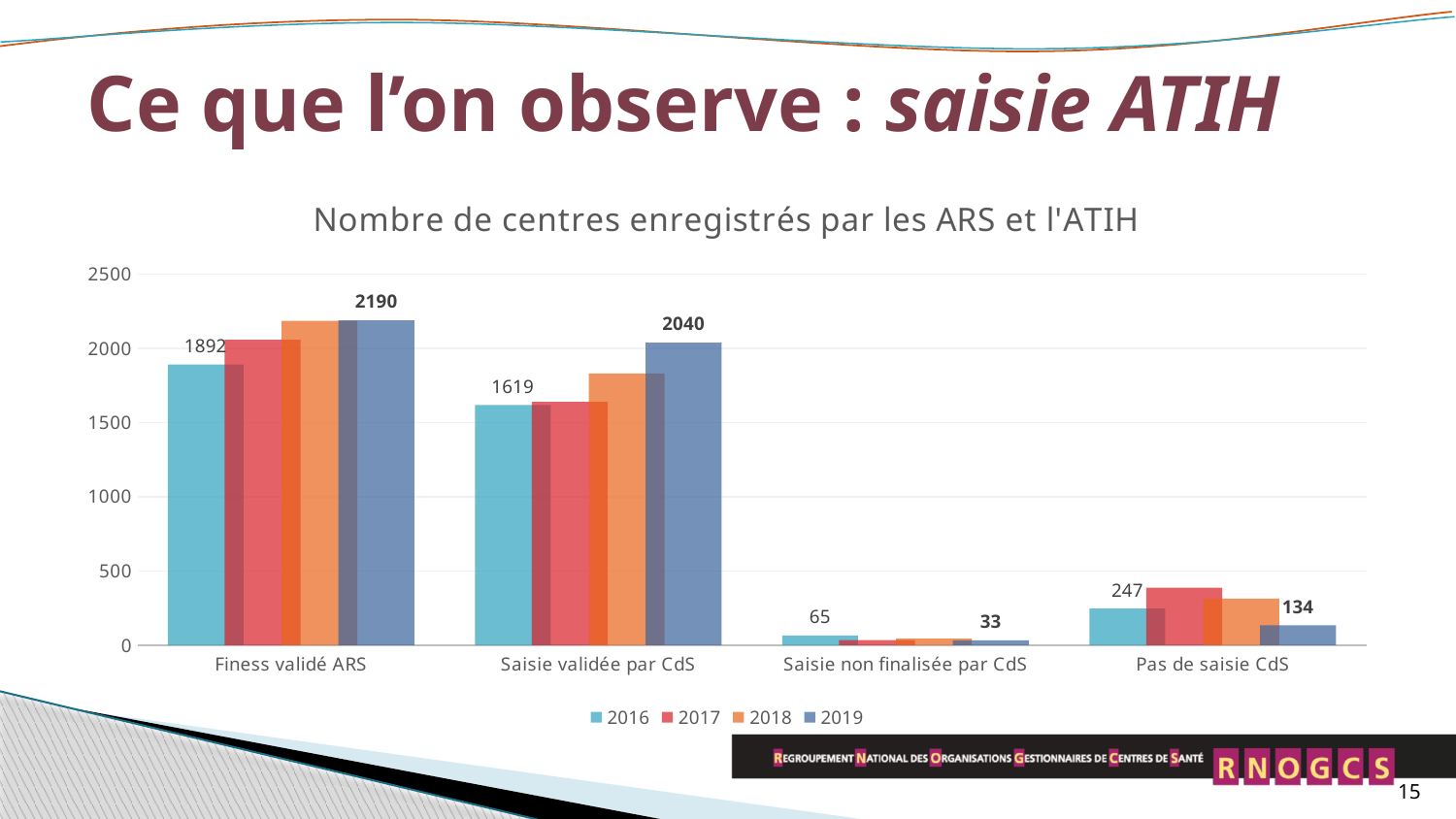
How many series does the legend list? 4 Which category has the lowest 2019 value? Saisie non finalisée par CdS Is the 2018 value for Saisie validée par CdS greater or less than 1500? greater How many categories are shown on the x axis? 4 What kind of chart is shown on the slide? bar chart What is the 2019 value for Pas de saisie CdS? 134 What is the 2016 value for Saisie non finalisée par CdS? 65 Is the 2016 value for Pas de saisie CdS greater or less than the 2019 value for the same category? greater What is the title of the chart? Nombre de centres enregistrés par les ARS et l'ATIH What is the difference between the 2019 and 2016 values for Finess validé ARS? 298 What is the 2019 value for Saisie validée par CdS? 2040 What is the 2016 value for Finess validé ARS? 1892